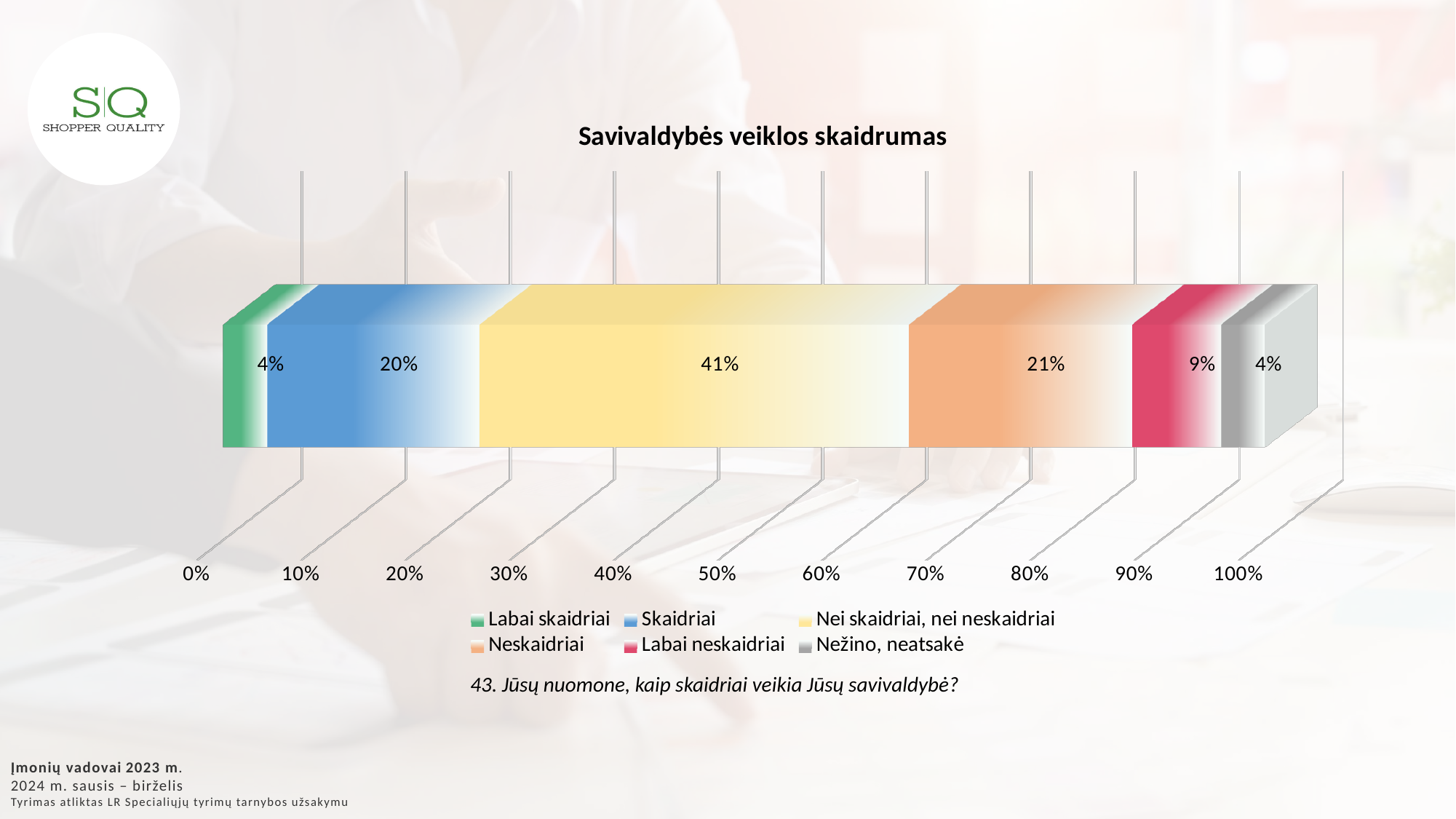
What is the difference in percentage points between the 'Neskaidriai' and 'Skaidriai' segments? 1 Which legend category has the largest share of the bar? Nei skaidriai, nei neskaidriai What percentage is shown for the 'Skaidriai' segment? 20% What is the total of the 'Labai skaidriai' and 'Skaidriai' segments combined? 24% Which is larger, the 'Skaidriai' segment or the 'Labai neskaidriai' segment? Skaidriai What kind of chart is shown on the slide? Stacked bar chart What is the title of the chart? Savivaldybės veiklos skaidrumas What percentage is shown for the 'Nei skaidriai, nei neskaidriai' segment? 41% What percentage is shown for the 'Labai neskaidriai' segment? 9% How many series does the legend list? 6 What percentage is shown for the 'Neskaidriai' segment? 21% What is the difference in percentage points between the 'Nei skaidriai, nei neskaidriai' and 'Labai neskaidriai' segments? 32